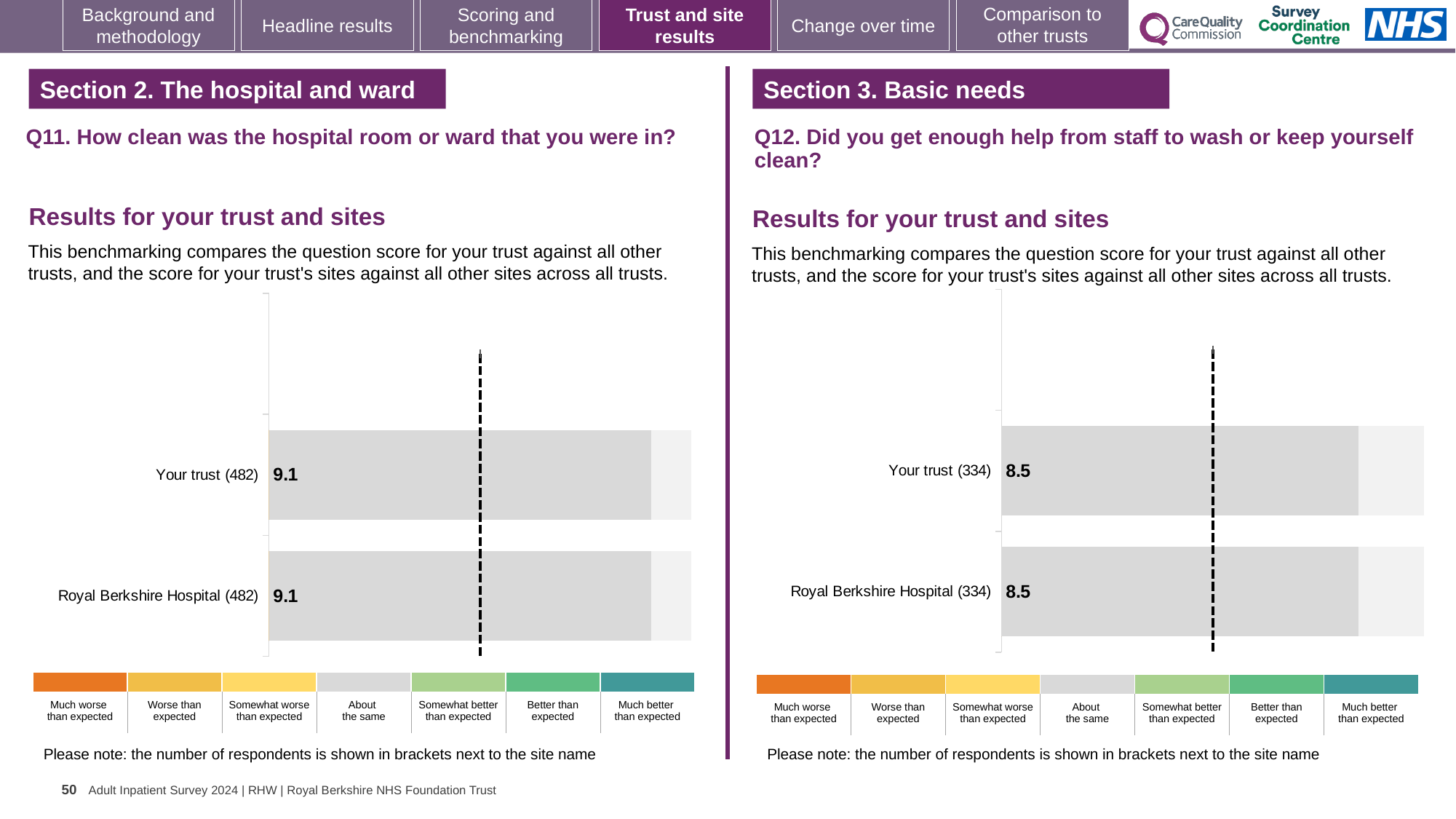
In the Q12 chart on the right, how many respondents are shown in brackets for Royal Berkshire Hospital? 334 In the Q12 chart on the right, what is the score for Your trust? 8.5 How many bars are plotted in the Q12 chart on the right? 2 In the Q11 chart on the left, what is the score for Royal Berkshire Hospital? 9.1 In the Q11 chart on the left, what is the score for Your trust? 9.1 What kind of chart is used for the Q11 results on the left? Bar chart How many bars are plotted in the Q11 chart on the left? 2 In the Q11 chart on the left, what is the difference between the score for Your trust and the score for Royal Berkshire Hospital? 0 In the Q11 chart on the left, how many respondents are shown in brackets for Your trust? 482 Is the score for Your trust in the Q11 chart on the left larger than the score for Your trust in the Q12 chart on the right? Yes In the Q12 chart on the right, what is the score for Royal Berkshire Hospital? 8.5 In the Q12 chart on the right, what is the difference between the score for Your trust and the score for Royal Berkshire Hospital? 0